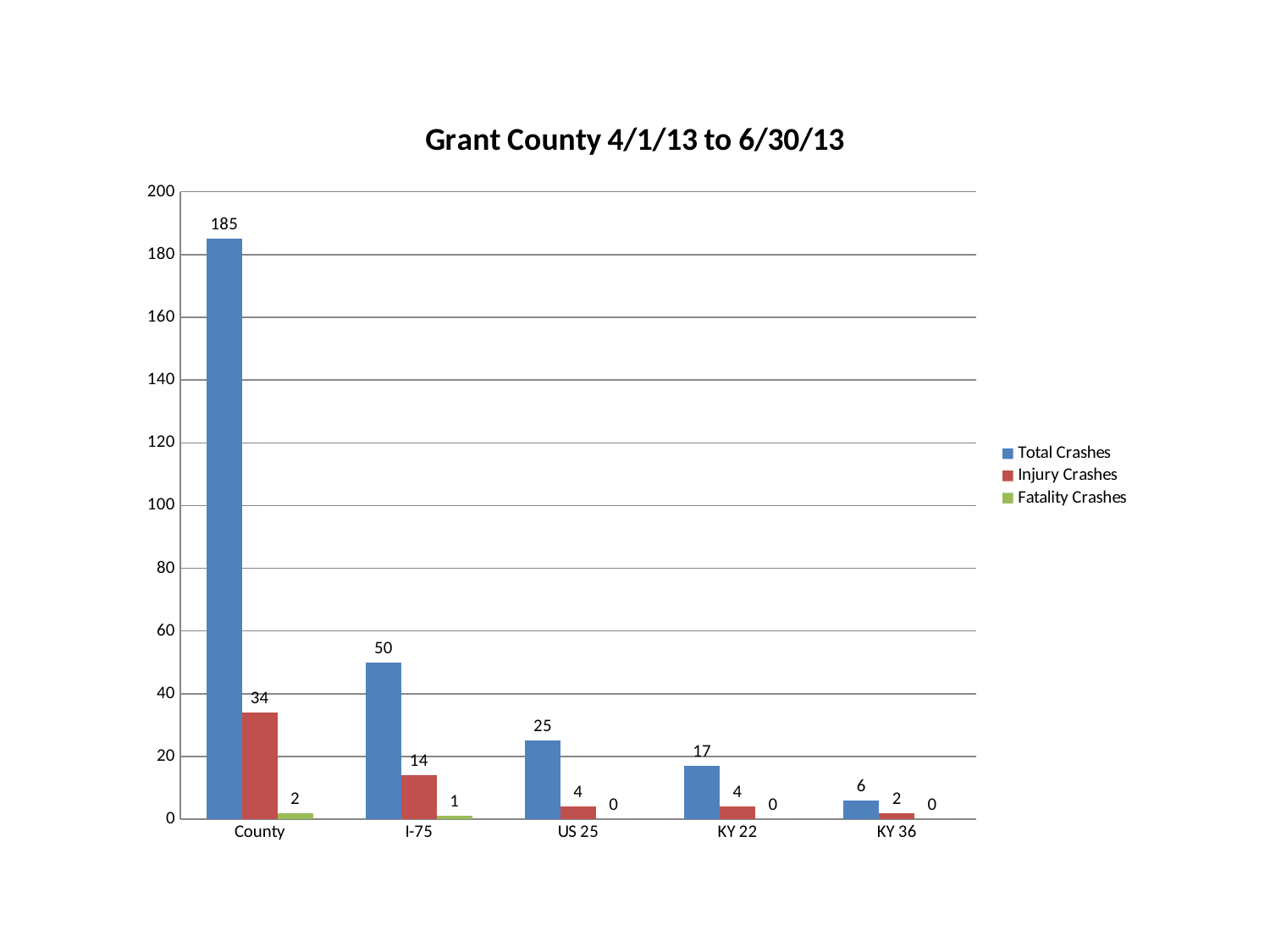
What is the value of Total Crashes for County? 185 What is the title of the chart? Grant County 4/1/13 to 6/30/13 Which category has the lowest Total Crashes? KY 36 What kind of chart is shown on the slide? Bar chart Which category has the highest Injury Crashes? County Do the Total Crashes values rise or fall from County to KY 36? Fall What is the value of Injury Crashes for I-75? 14 What is the value of Fatality Crashes for KY 22? 0 Which is larger: Injury Crashes for County or Total Crashes for I-75? Total Crashes for I-75 What is the difference between Total Crashes for I-75 and Total Crashes for US 25? 25 How many series does the legend list? 3 How many categories are shown on the x axis? 5